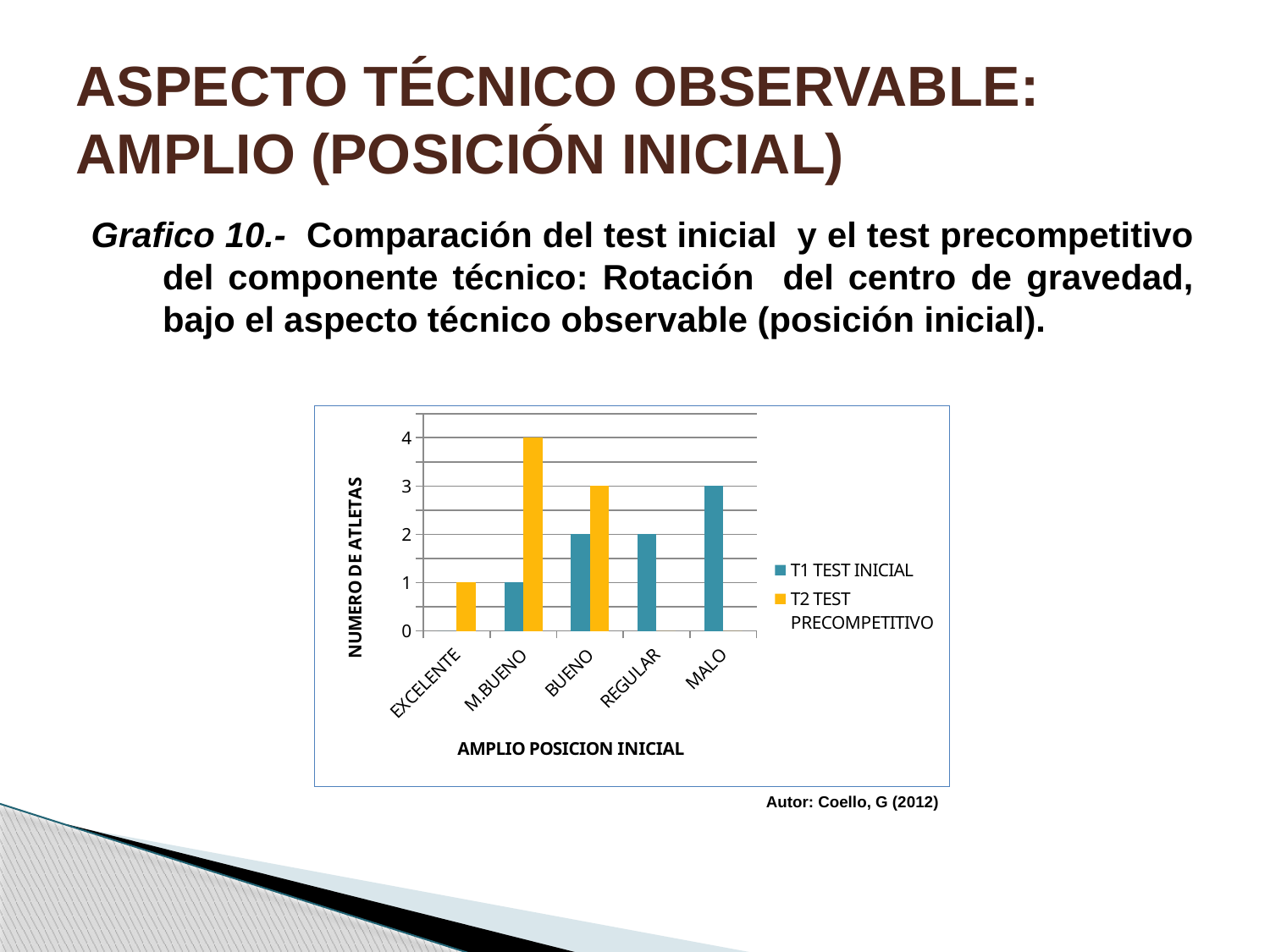
For BUENO, which series has the larger value, T1 TEST INICIAL or T2 TEST PRECOMPETITIVO? T2 TEST PRECOMPETITIVO What is the value of T2 TEST PRECOMPETITIVO for M.BUENO? 4 How many series does the legend list? 2 Which category has the highest value for T2 TEST PRECOMPETITIVO? M.BUENO What is the difference between T2 TEST PRECOMPETITIVO and T1 TEST INICIAL for M.BUENO? 3 What is the value of T2 TEST PRECOMPETITIVO for EXCELENTE? 1 What is the value of T1 TEST INICIAL for BUENO? 2 What type of chart is shown on the slide? bar chart Which category has the highest value for T1 TEST INICIAL? MALO What is the value of T1 TEST INICIAL for MALO? 3 How many categories are shown on the x axis? 5 What is the label of the y axis? NUMERO DE ATLETAS